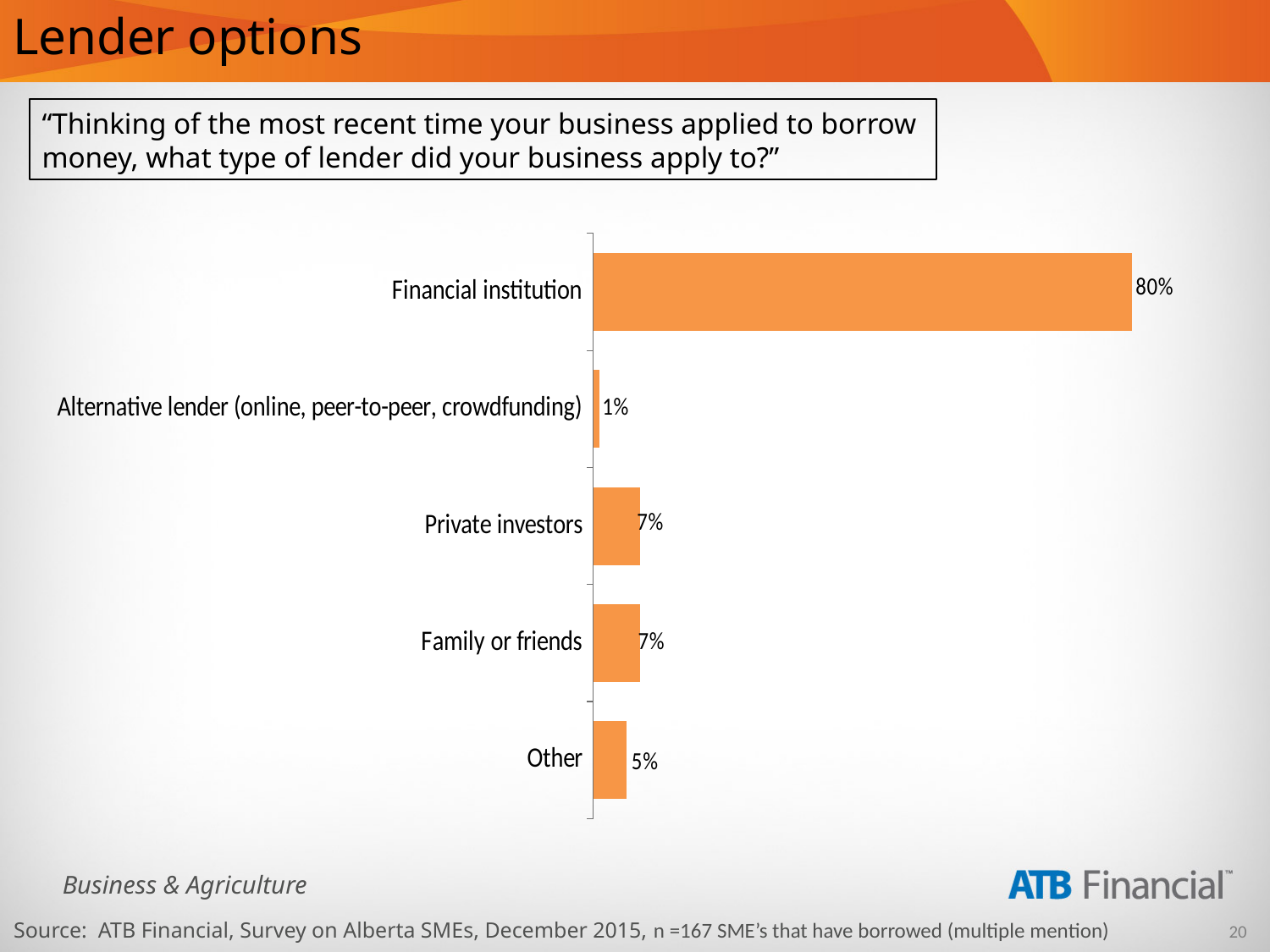
Which is larger, the value for Other or the value for Alternative lender? Other Which lender type has the highest value? Financial institution What is the difference between the values for Financial institution and Private investors? 73% What percentage of businesses applied to a financial institution? 80% What is the value for Other? 5% What kind of chart is shown on the slide? Bar chart Which lender type has the lowest value? Alternative lender (online, peer-to-peer, crowdfunding) What colour are the bars in the chart? Orange What is the value for Alternative lender (online, peer-to-peer, crowdfunding)? 1% What is the difference between the values for Family or friends and Other? 2% What is the value for Private investors? 7% How many lender categories are shown in the chart? 5